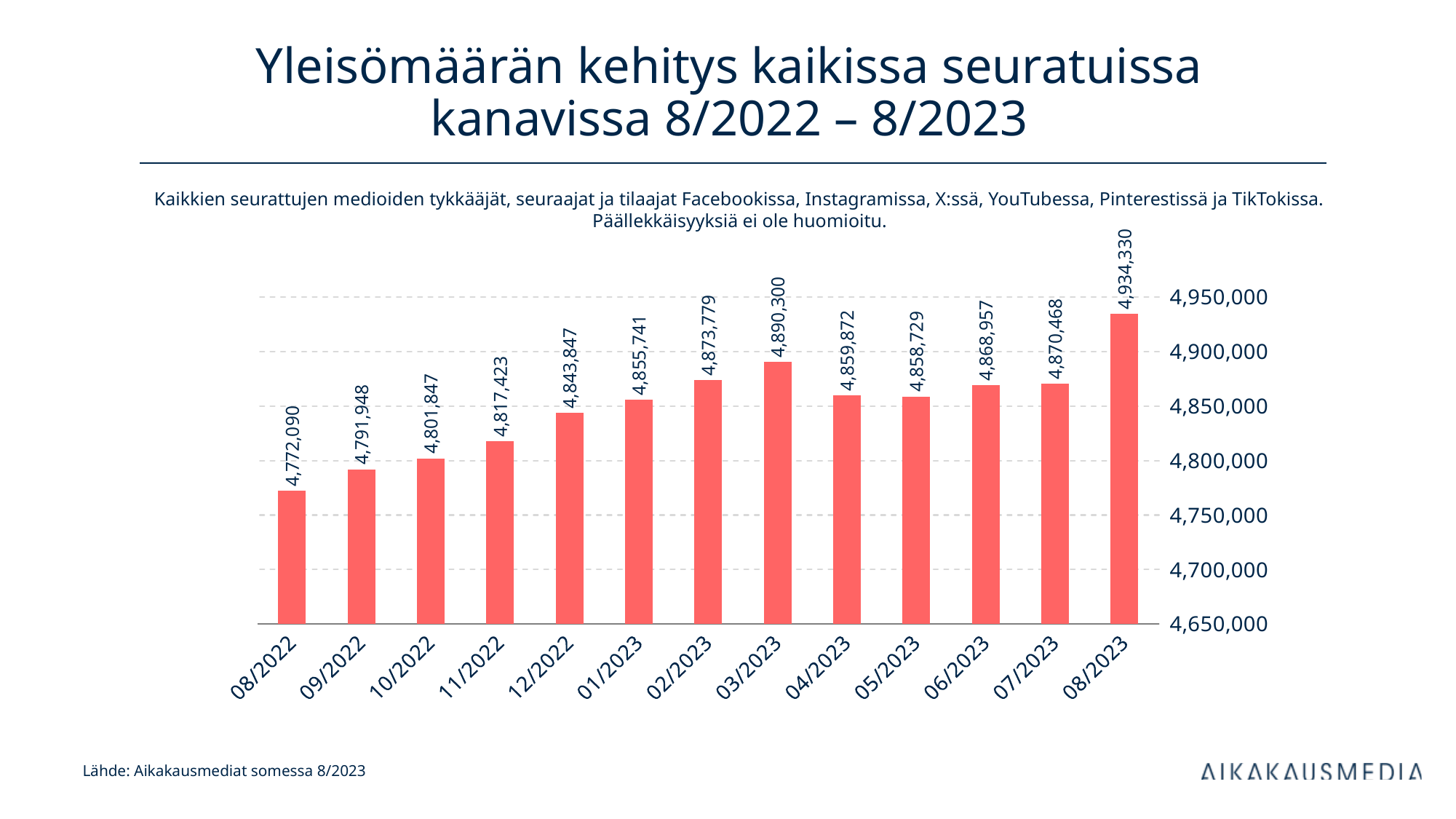
Is the value for 11/2022 greater or less than 4,800,000? greater What is the source cited at the bottom of the slide? Aikakausmediat somessa 8/2023 What is the value for 03/2023? 4,890,300 What is the difference between the values for 08/2023 and 08/2022? 162,240 What kind of chart is shown on the slide? bar chart What is the difference between the values for 03/2023 and 04/2023? 30,428 What is the value for 08/2022? 4,772,090 Which month has the highest value? 08/2023 Which month has the lowest value? 08/2022 What is the value for 08/2023? 4,934,330 How many months are shown on the x axis? 13 Which is larger, the value for 02/2023 or the value for 06/2023? 02/2023